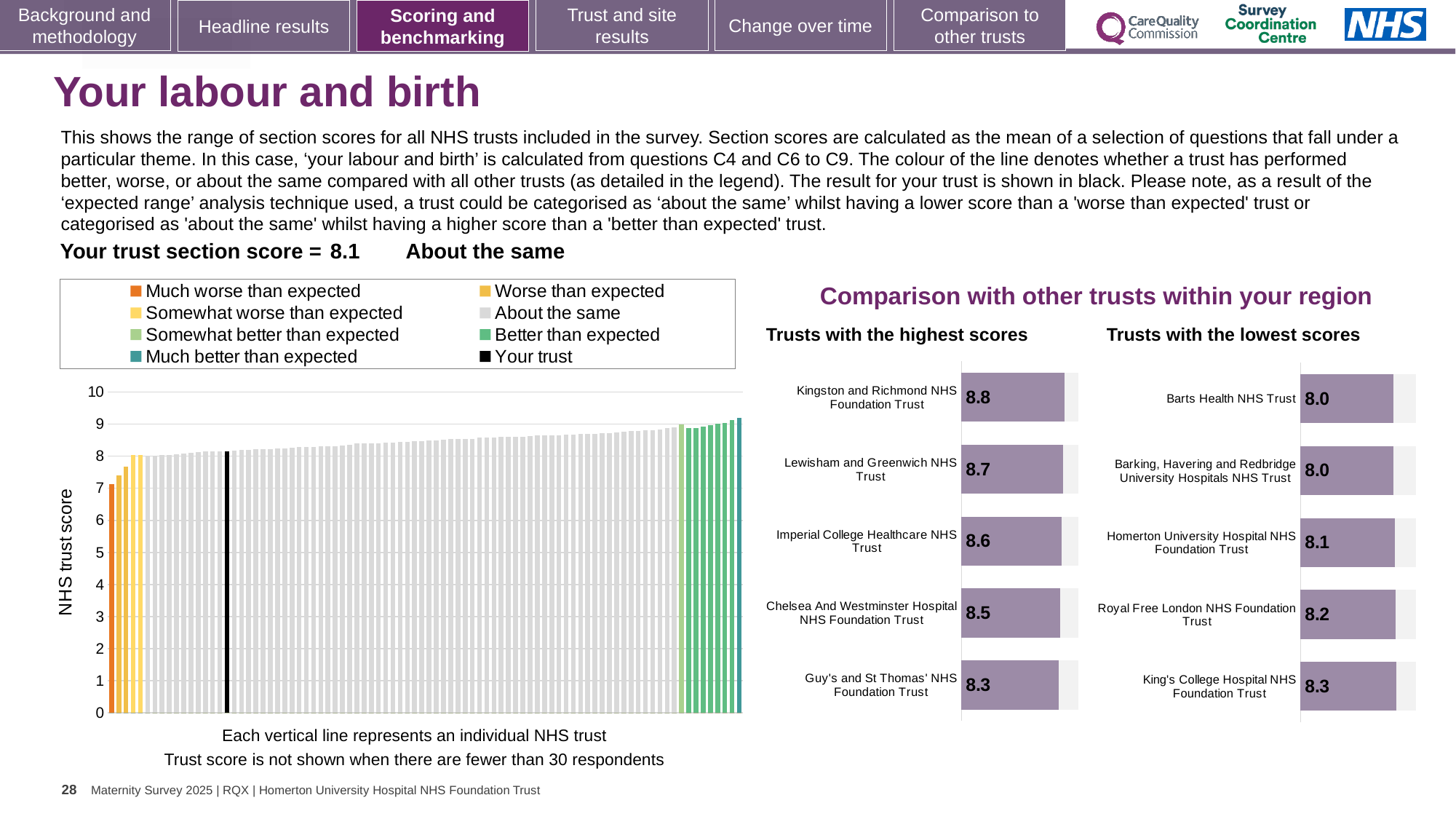
How many trusts are shown in the 'Trusts with the lowest scores' chart? 5 In the 'Trusts with the highest scores' chart, what is the difference between the scores of Kingston and Richmond NHS Foundation Trust and Guy's and St Thomas' NHS Foundation Trust? 0.5 In the 'Trusts with the lowest scores' chart, which trust has the highest score? King's College Hospital NHS Foundation Trust How many entries does the legend above the large chart on the left list? 8 In the 'Trusts with the lowest scores' chart, what is the score for Homerton University Hospital NHS Foundation Trust? 8.1 In the 'Trusts with the highest scores' chart, which trust has the lowest score? Guy's and St Thomas' NHS Foundation Trust What kind of chart is the large chart on the left showing NHS trust scores? Bar chart In the 'Trusts with the lowest scores' chart, what is the difference between the scores of King's College Hospital NHS Foundation Trust and Barts Health NHS Trust? 0.3 In the 'Trusts with the highest scores' chart, what is the score for Kingston and Richmond NHS Foundation Trust? 8.8 In the 'Trusts with the highest scores' chart, what is the score for Imperial College Healthcare NHS Trust? 8.6 In the 'Trusts with the lowest scores' chart, which has the larger score: Royal Free London NHS Foundation Trust or Homerton University Hospital NHS Foundation Trust? Royal Free London NHS Foundation Trust In the large chart on the left, do the bar values rise or fall from left to right along the x axis? Rise